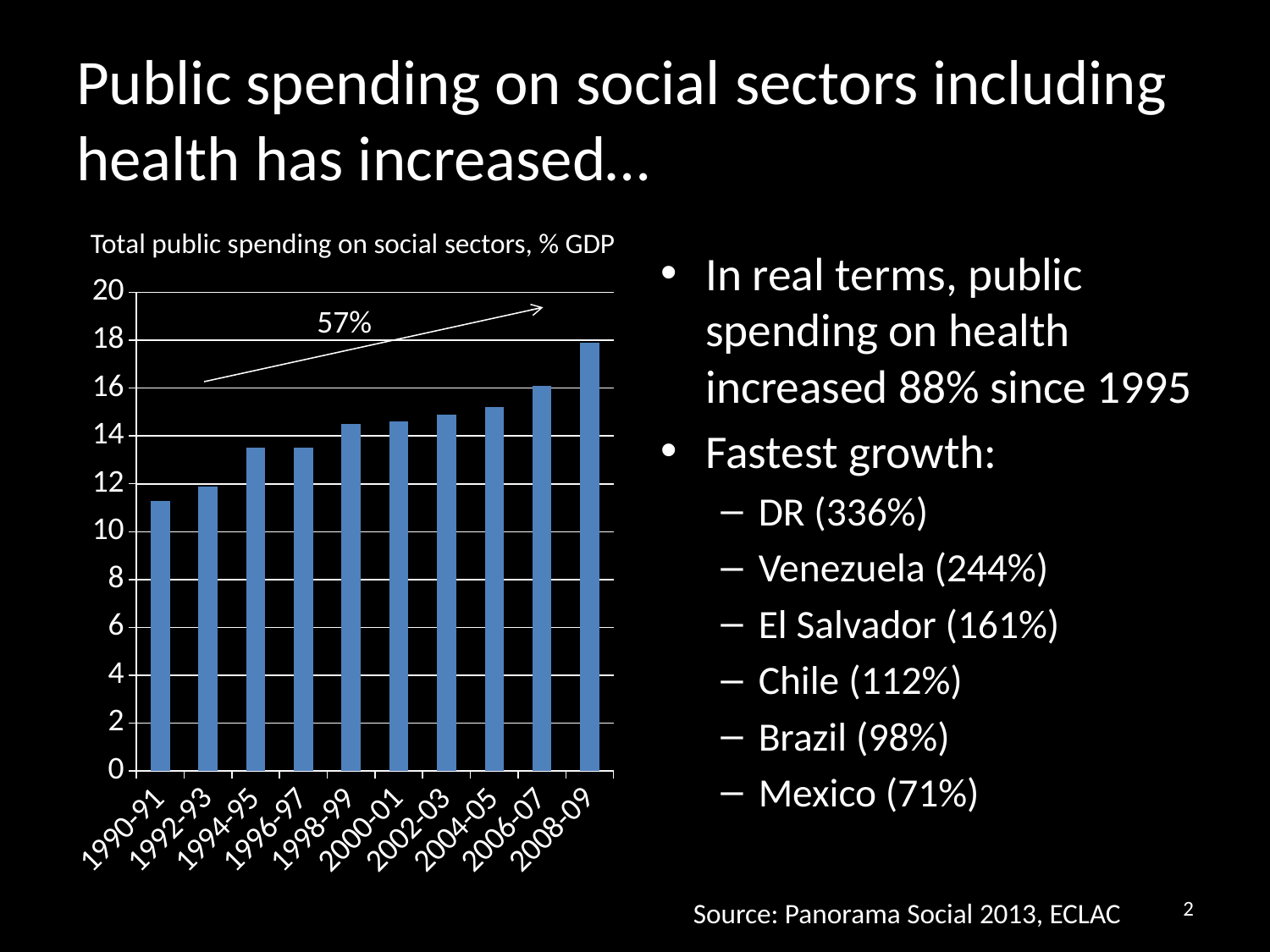
Is the value for 2008-09 greater or less than 16? greater What percentage is written next to the arrow annotation on the chart? 57% How many bars (periods) are plotted in the chart? 10 Which is larger, the value for 2006-07 or the value for 1994-95? 2006-07 Which period has the highest total public spending on social sectors as % of GDP? 2008-09 Do the values generally rise or fall from 1990-91 to 2008-09? rise Is the value for 2006-07 greater or less than 14? greater Is the value for 1990-91 greater or less than 12? less What kind of chart is shown on the slide? bar chart What is the title of the chart? Total public spending on social sectors, % GDP Which period has the lowest total public spending on social sectors as % of GDP? 1990-91